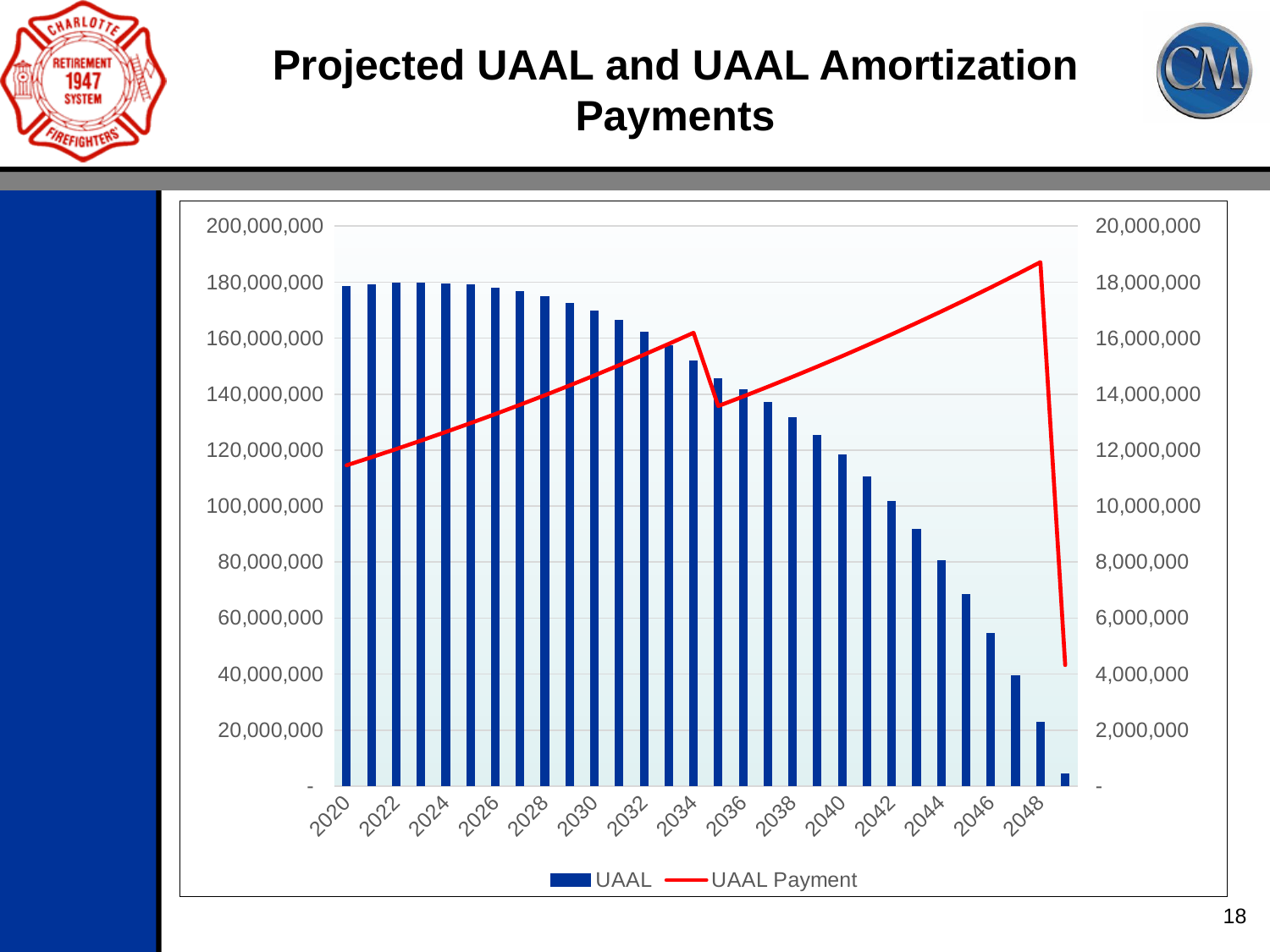
Is the UAAL Payment value for 2049 greater or less than 6,000,000? less Is the UAAL Payment value for 2020 greater or less than 10,000,000? greater Which series is plotted as blue bars? UAAL In which year does the UAAL Payment line reach its highest point? 2048 Is the UAAL value for 2048 greater or less than 40,000,000? less Which year has the lowest UAAL bar? 2049 Which series is drawn as a red line? UAAL Payment How many series does the legend list? 2 What kind of chart is shown on the slide? A combination bar and line chart Which is larger, the UAAL for 2030 or the UAAL for 2040? 2030